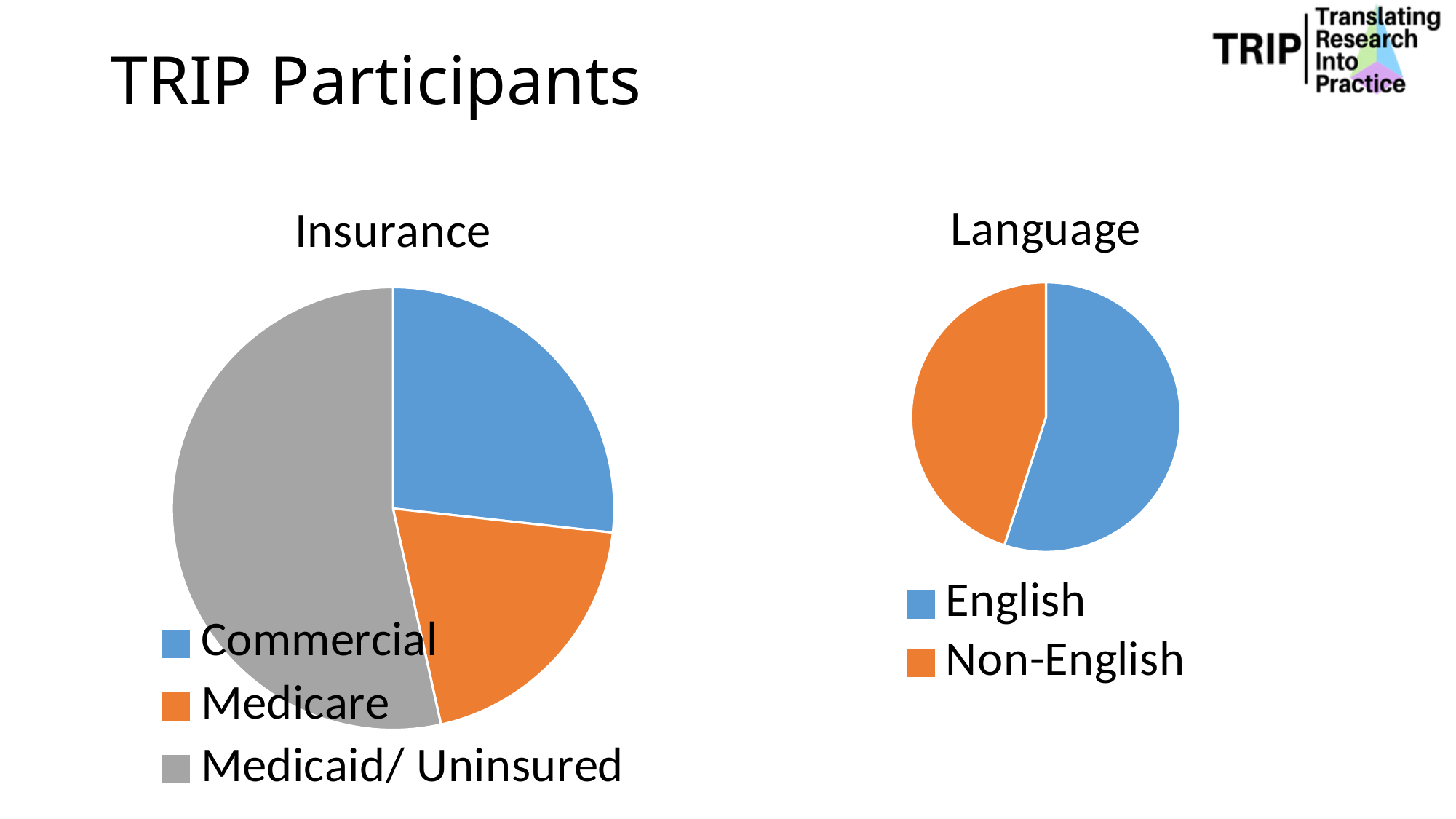
What kind of chart is the Insurance chart? pie chart What kind of chart is the Language chart? pie chart In the Language chart, how many categories are shown? 2 In the Insurance chart, how many categories are shown? 3 In the Language chart, which is larger, English or Non-English? English In the Insurance chart, which category has the smallest slice? Medicare In the Insurance chart, what colour is the Medicaid/ Uninsured slice? grey In the Insurance chart, which is larger, Commercial or Medicare? Commercial In the Language chart, which category has the largest slice? English In the Insurance chart, which category has the largest slice? Medicaid/ Uninsured In the Language chart, what colour is the Non-English slice? orange In the Insurance chart, which is larger, Medicaid/ Uninsured or Commercial? Medicaid/ Uninsured